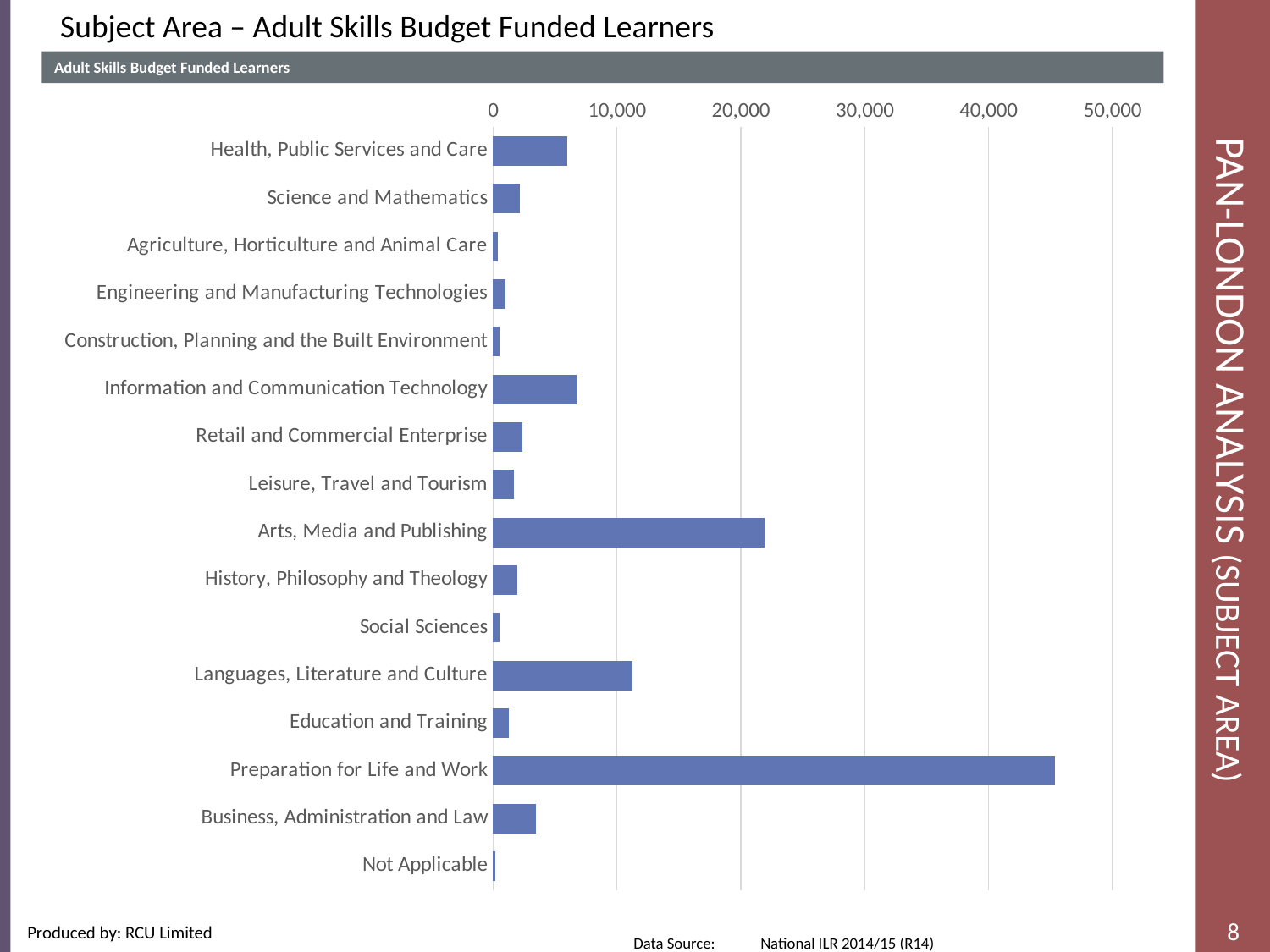
Which subject area has the highest number of Adult Skills Budget funded learners? Preparation for Life and Work Which has more funded learners: Business, Administration and Law or Education and Training? Business, Administration and Law Which subject area has the lowest number of Adult Skills Budget funded learners? Not Applicable Is the value for Health, Public Services and Care greater or less than 10,000? less Is the value for Preparation for Life and Work greater or less than 40,000? greater Which has more funded learners: Arts, Media and Publishing or Languages, Literature and Culture? Arts, Media and Publishing Which has more funded learners: Information and Communication Technology or Science and Mathematics? Information and Communication Technology Is the value for Languages, Literature and Culture greater or less than 10,000? greater What is the title shown in the header bar above the chart? Adult Skills Budget Funded Learners How many subject area categories are plotted in the chart? 16 What kind of chart is shown on the slide? bar chart